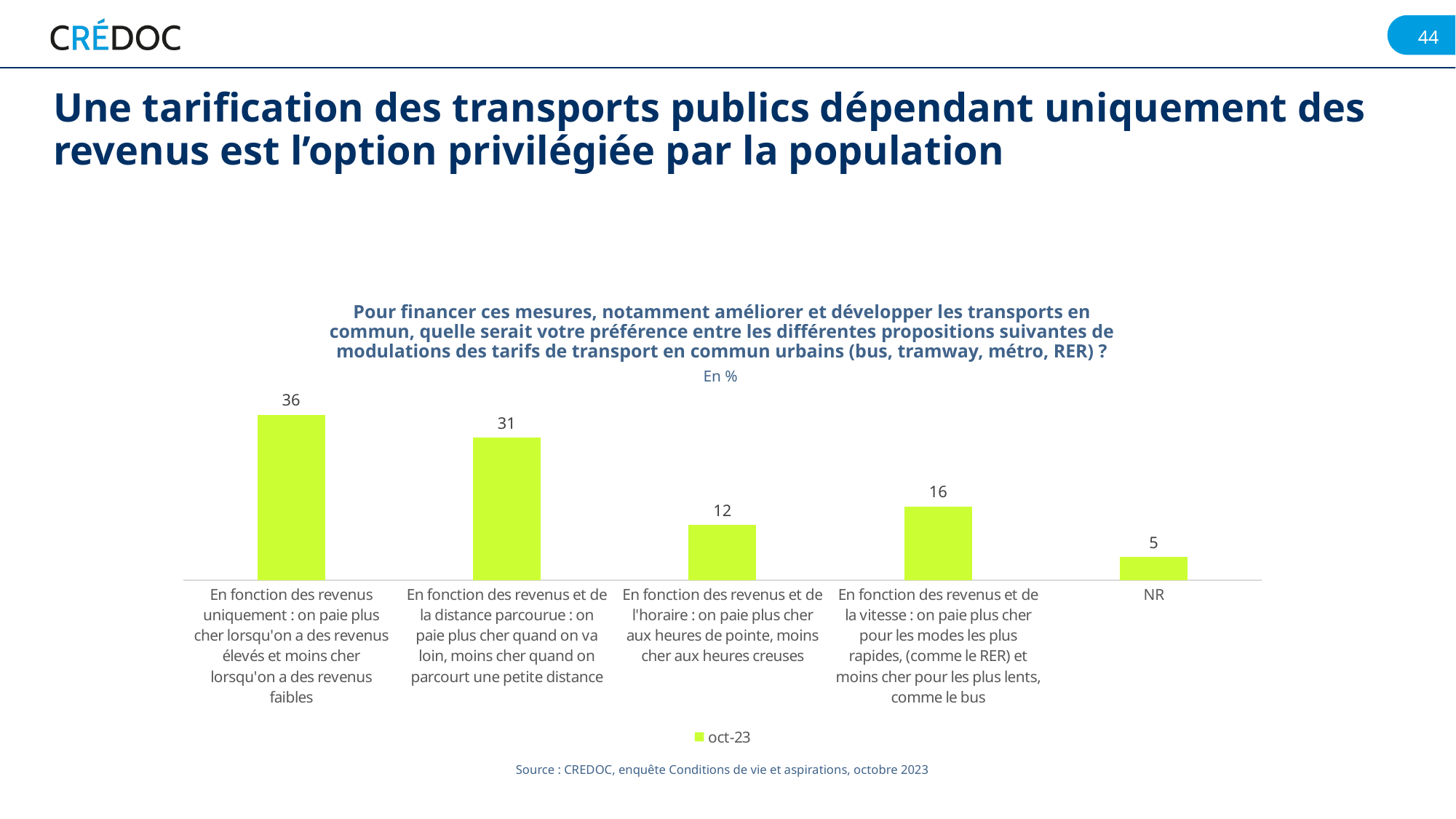
What is the value for 'En fonction des revenus et de la vitesse'? 16 What is the difference between 'En fonction des revenus uniquement' and 'En fonction des revenus et de la distance parcourue'? 5 What is the value for 'En fonction des revenus uniquement'? 36 Which category has the lowest value? NR Which category has the highest value? En fonction des revenus uniquement How many categories are shown on the chart? 5 What is the value for 'En fonction des revenus et de l'horaire'? 12 What is the value for 'NR'? 5 What kind of chart is shown on the slide? Bar chart What is the value for 'En fonction des revenus et de la distance parcourue'? 31 Which is larger: 'En fonction des revenus et de l'horaire' or 'En fonction des revenus et de la vitesse'? En fonction des revenus et de la vitesse How many series does the legend list? 1